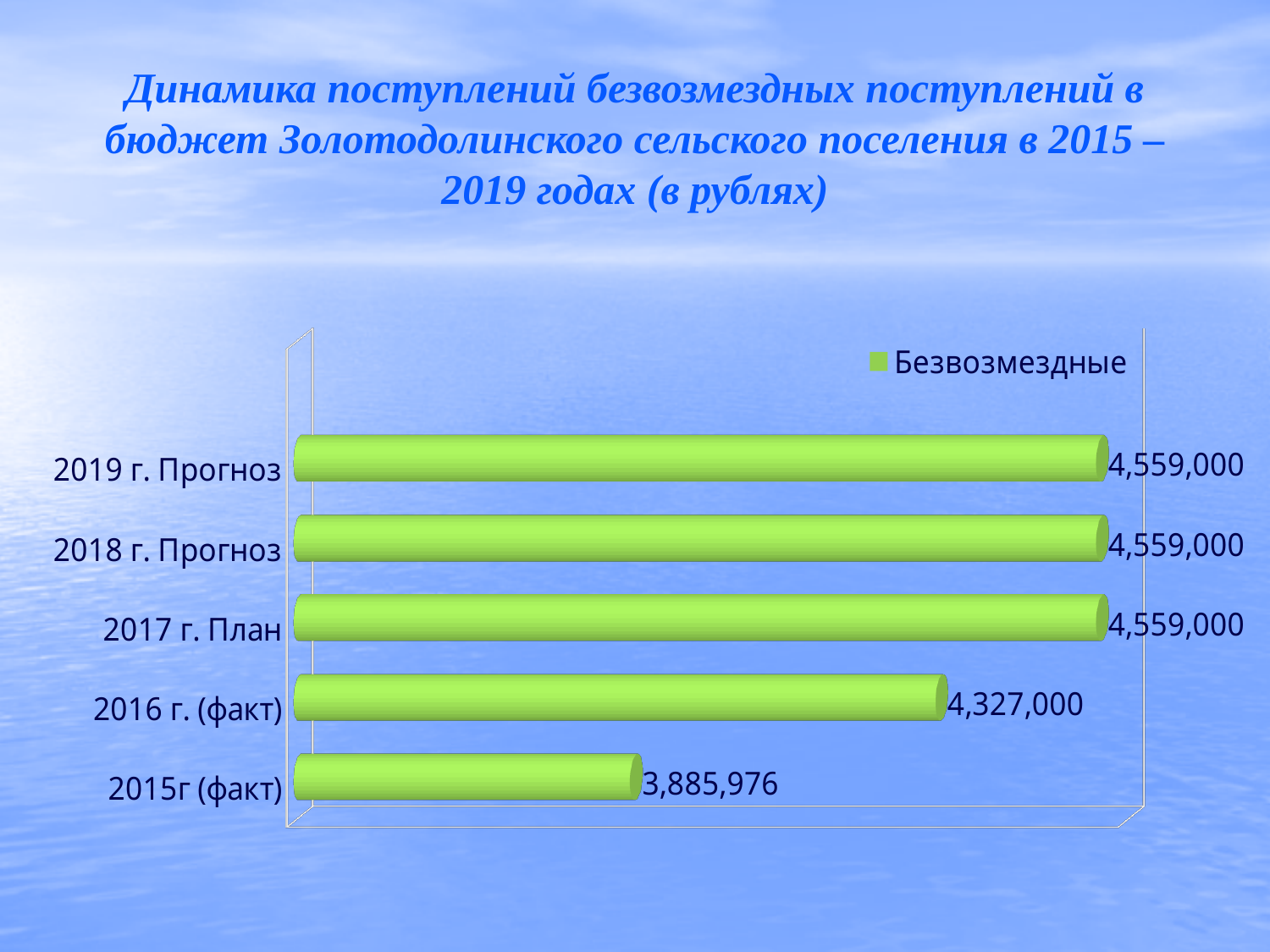
What is the value for 2015г (факт)? 3,885,976 What is the difference between the values for 2016 г. (факт) and 2015г (факт)? 441,024 What is the value for 2019 г. Прогноз? 4,559,000 What kind of chart is shown on the slide? bar chart What is the value for 2016 г. (факт)? 4,327,000 Which category has the lowest value? 2015г (факт) How many categories are shown in the chart? 5 What is the name of the series shown in the legend? Безвозмездные Which is larger, the value for 2016 г. (факт) or the value for 2015г (факт)? 2016 г. (факт) How many series does the legend list? 1 What is the value for 2017 г. План? 4,559,000 What is the difference between the values for 2017 г. План and 2016 г. (факт)? 232,000